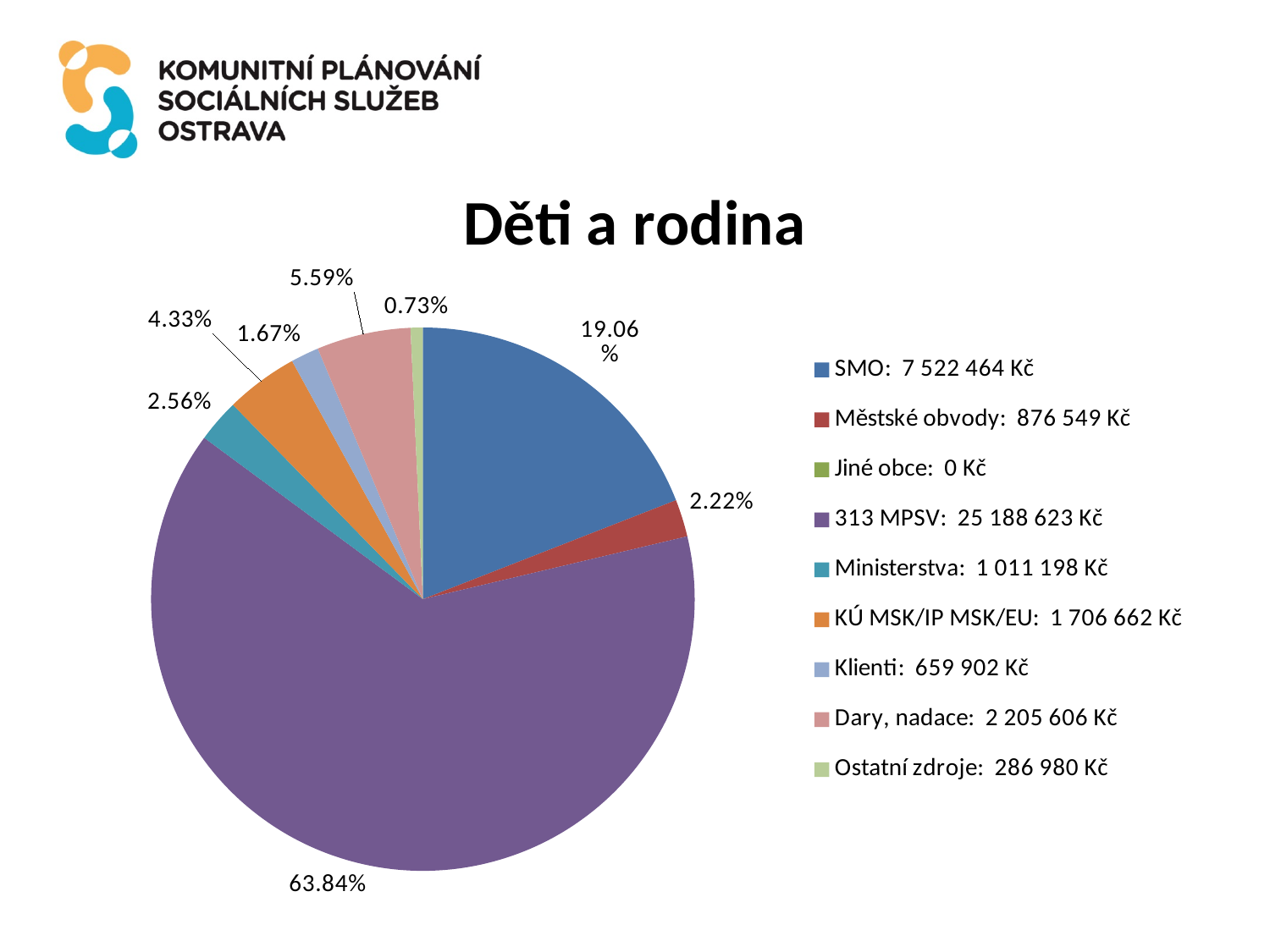
What is the difference between the amounts for KÚ MSK/IP MSK/EU and Klienti? 1 046 760 Kč What amount is shown for 313 MPSV in the legend? 25 188 623 Kč What amount is shown for SMO in the legend? 7 522 464 Kč How many entries does the chart legend list? 9 What is the title of the chart? Děti a rodina What percentage share does the largest slice (313 MPSV) have? 63.84% What percentage share does the SMO slice have? 19.06% What amount is shown for Dary, nadace in the legend? 2 205 606 Kč Which is larger, the amount for Ministerstva or the amount for Klienti? Ministerstva What amount is shown for Jiné obce in the legend? 0 Kč Which source has the largest share of the pie? 313 MPSV What type of chart is shown on the slide? pie chart